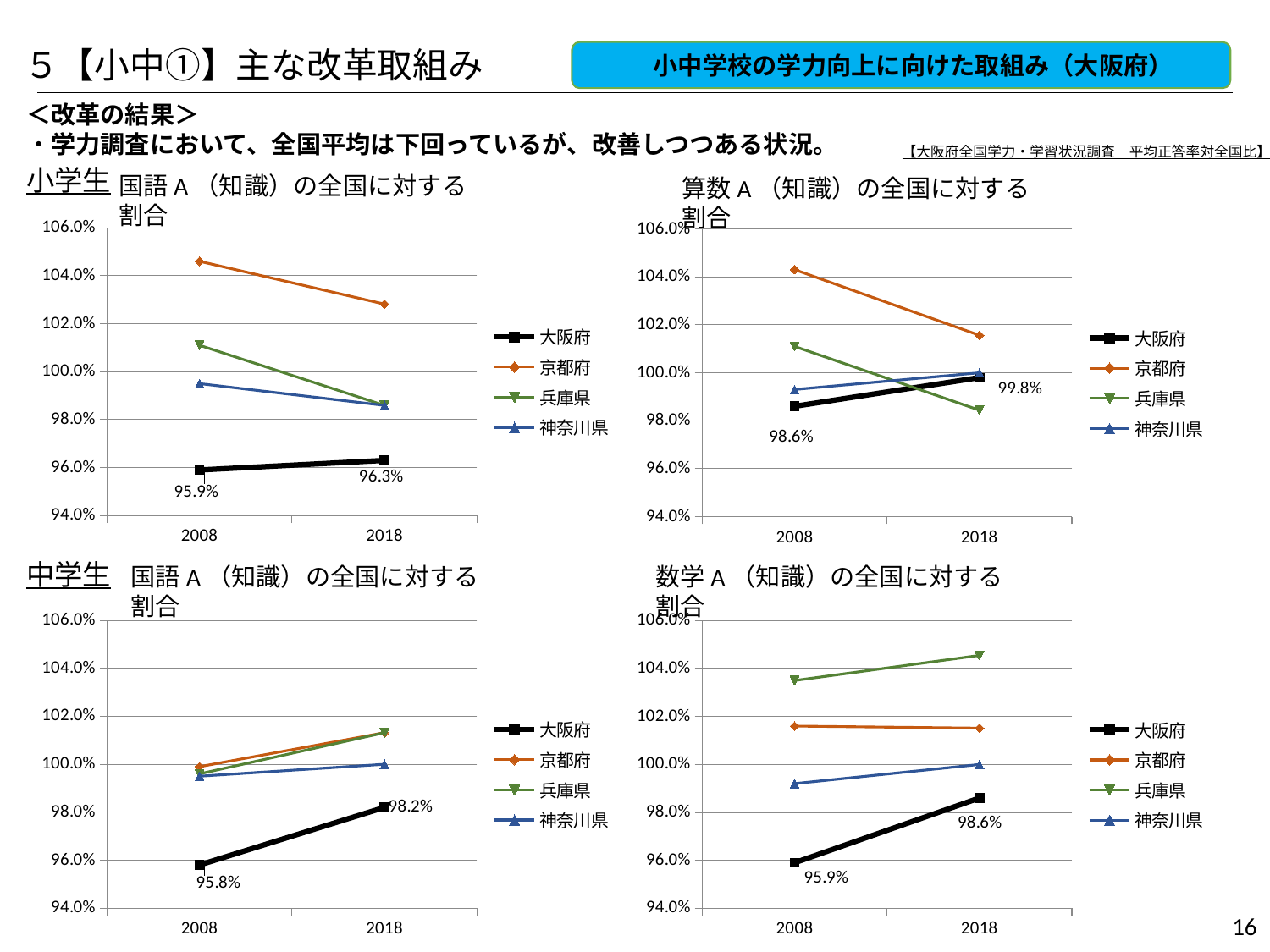
In the bottom-right chart (中学生 数学A), is the value for 兵庫県 in 2018 greater or less than 104.0%? greater In the bottom-right chart (中学生 数学A), by how much did the 大阪府 value increase from 2008 to 2018? 2.7% In the top-left chart (小学生 国語A), what is the value for 大阪府 in 2008? 95.9% In the top-left chart (小学生 国語A), does the 京都府 line rise or fall from 2008 to 2018? fall In the bottom-left chart (中学生 国語A), what is the value for 大阪府 in 2008? 95.8% In the bottom-right chart (中学生 数学A), which prefecture has the lowest value in 2008? 大阪府 In the top-left chart (小学生 国語A), which prefecture has the highest value in 2008? 京都府 In the top-left chart (小学生 国語A), what is the value for 大阪府 in 2018? 96.3% How many series does the legend of the top-left chart (小学生 国語A) list? 4 In the top-right chart (小学生 算数A), what is the value for 大阪府 in 2018? 99.8% In the bottom-left chart (中学生 国語A), does the 大阪府 line rise or fall from 2008 to 2018? rise In the top-right chart (小学生 算数A), what is the difference between the 大阪府 values for 2018 and 2008? 1.2%